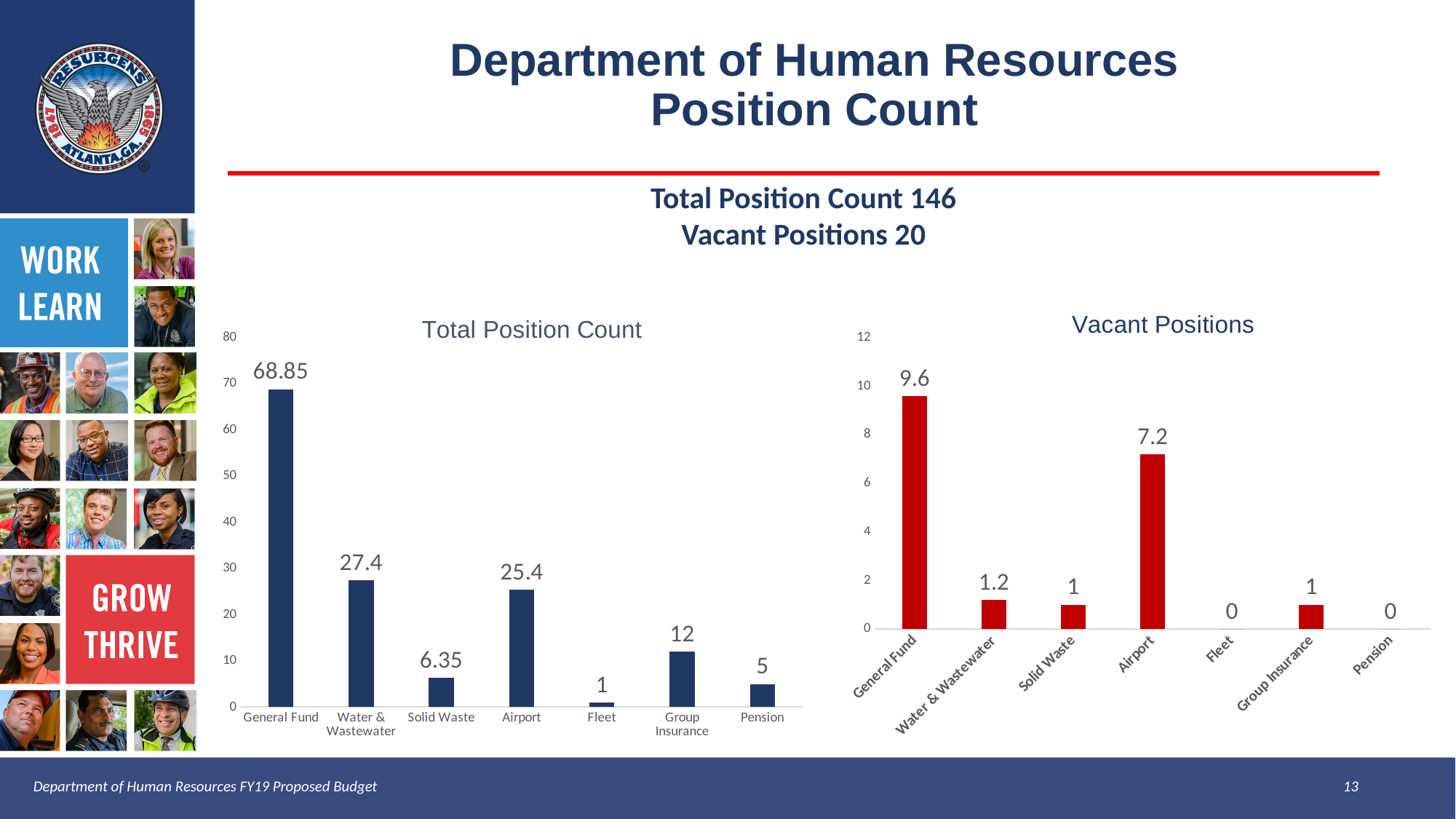
In the Vacant Positions chart, which category has the highest value? General Fund What kind of chart is the Total Position Count chart? Bar chart In the Total Position Count chart, what is the value for General Fund? 68.85 In the Total Position Count chart, which is larger, Group Insurance or Pension? Group Insurance In the Total Position Count chart, what is the difference between Water & Wastewater and Airport? 2 In the Vacant Positions chart, what is the value for Water & Wastewater? 1.2 In the Vacant Positions chart, what is the difference between General Fund and Airport? 2.4 In the Total Position Count chart, what is the value for Solid Waste? 6.35 In the Total Position Count chart, which category has the lowest value? Fleet How many categories are shown in the Vacant Positions chart? 7 In the Total Position Count chart, which category has the highest value? General Fund In the Vacant Positions chart, what is the value for Airport? 7.2